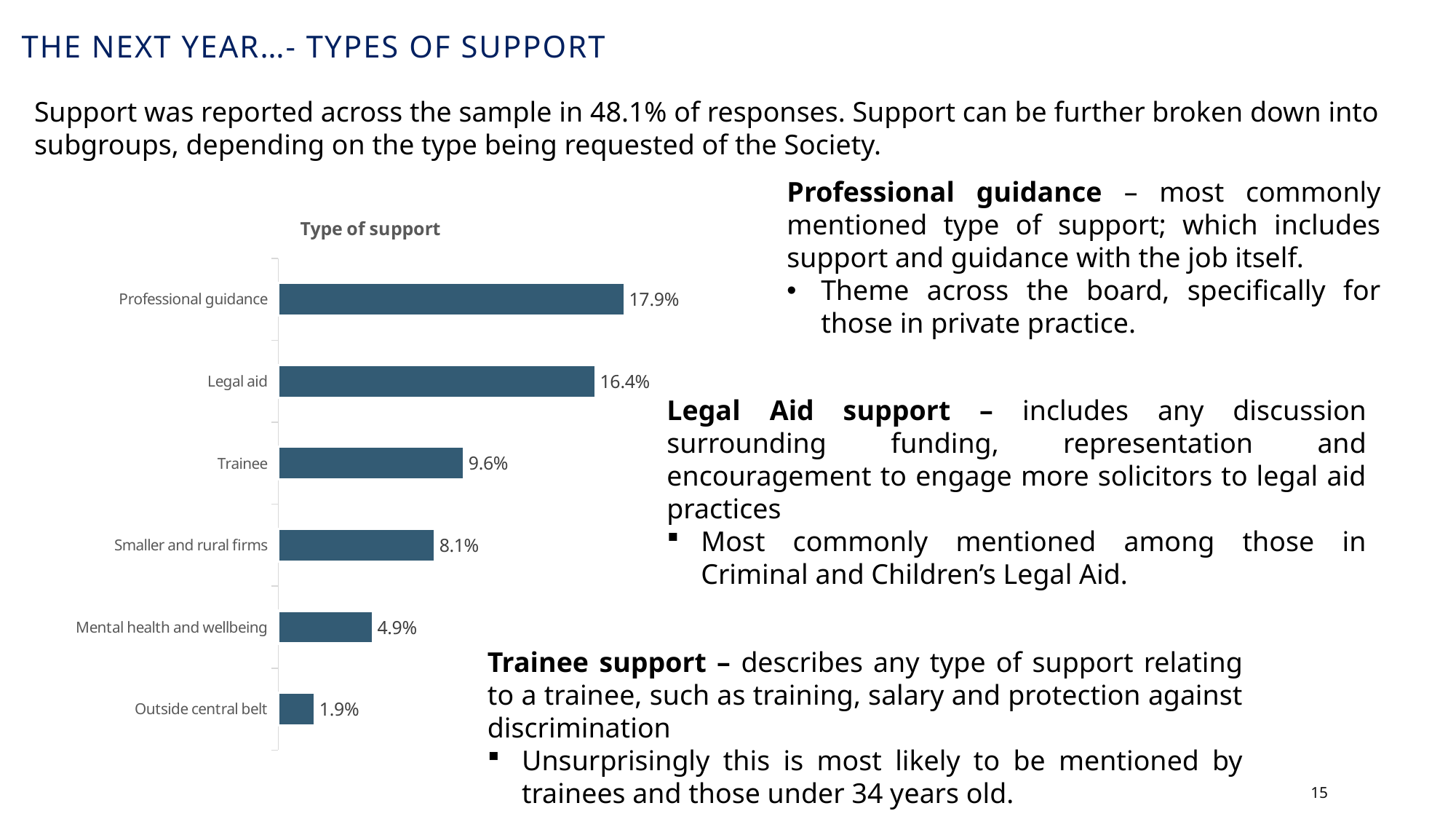
Which type of support has the lowest value? Outside central belt What is the difference between the values for Trainee and Smaller and rural firms? 1.5% What is the value for Mental health and wellbeing? 4.9% What is the title of the chart? Type of support Which is larger, the value for Trainee or the value for Mental health and wellbeing? Trainee What kind of chart is shown on the slide? Bar chart What is the value for Outside central belt? 1.9% What is the value for Professional guidance? 17.9% What is the difference between the values for Professional guidance and Legal aid? 1.5% What is the value for Legal aid? 16.4% How many categories are shown in the chart? 6 Which type of support has the highest value? Professional guidance